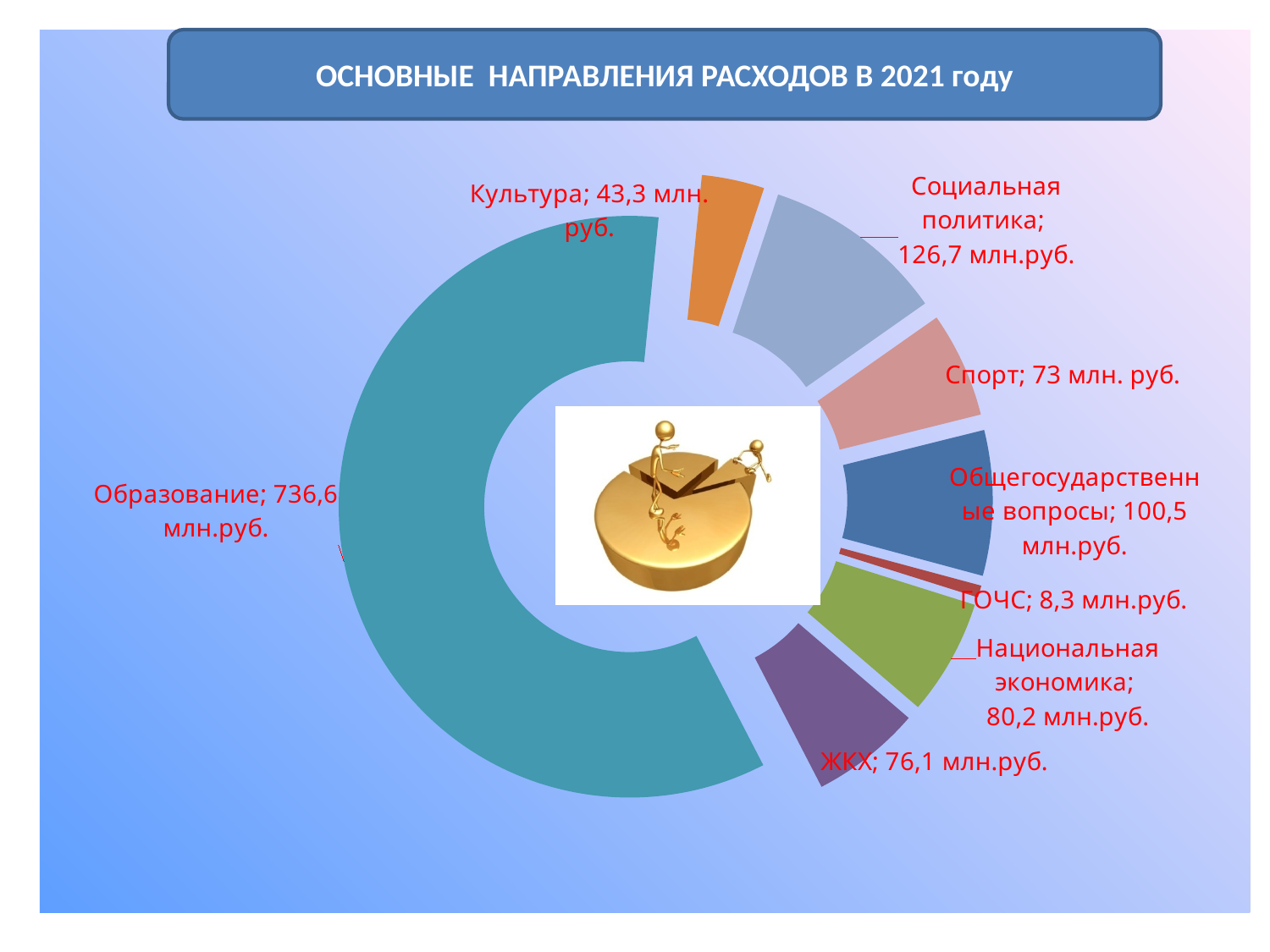
What is the difference between Образование and Социальная политика? 609,9 млн.руб. Which category has the highest value? Образование What is the value for Социальная политика? 126,7 млн.руб. What is the value for Национальная экономика? 80,2 млн.руб. What kind of chart is shown on the slide? doughnut chart Which is larger, Спорт or ЖКХ? ЖКХ What is the value for Образование? 736,6 млн.руб. Which category has the lowest value? ГОЧС What is the difference between Социальная политика and Общегосударственные вопросы? 26,2 млн.руб. What is the value for ГОЧС? 8,3 млн.руб. How many categories does the chart show? 8 What is the title of the slide? ОСНОВНЫЕ НАПРАВЛЕНИЯ РАСХОДОВ В 2021 году